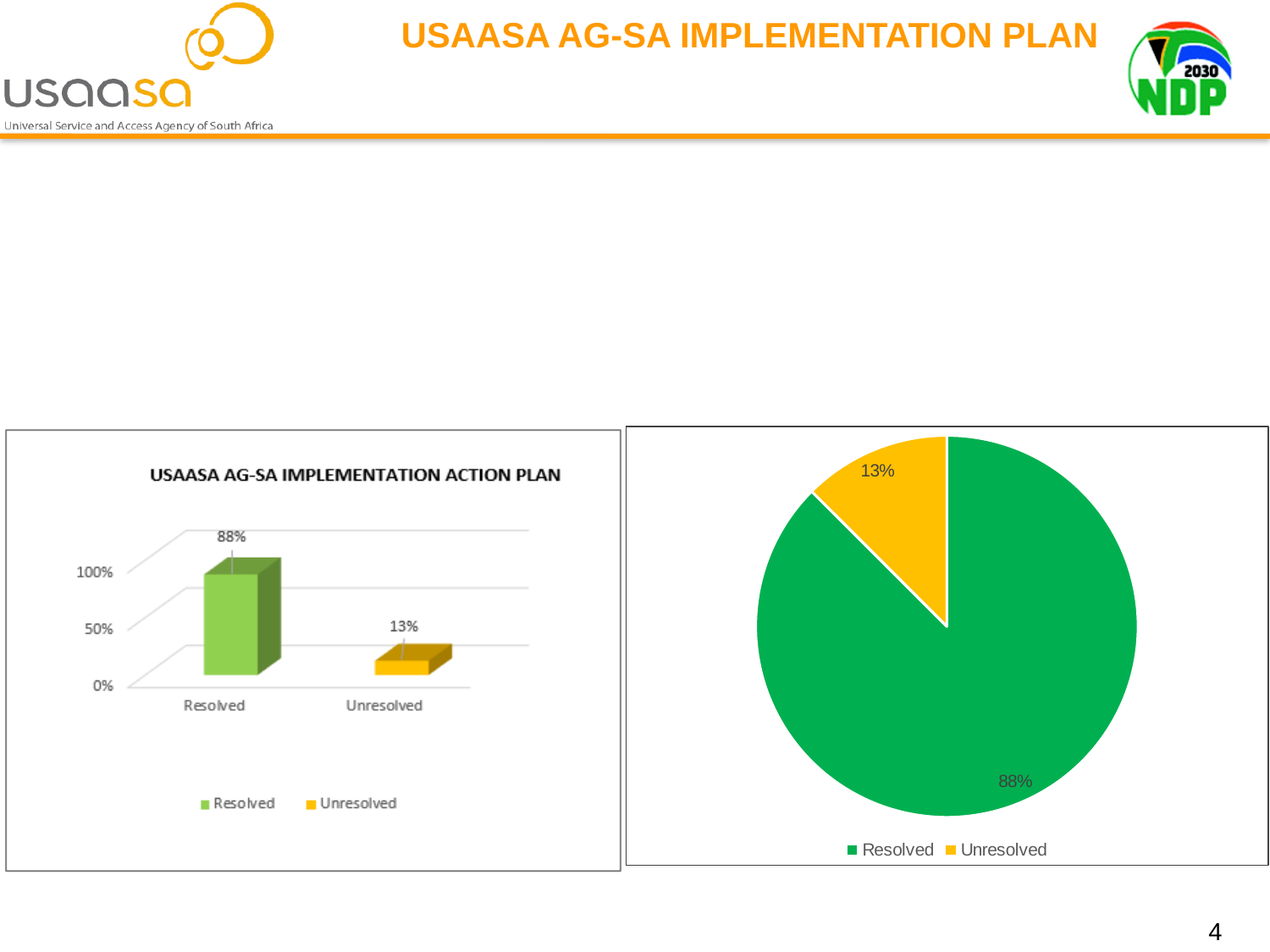
In the bar chart on the left, which category has the lowest value? Unresolved In the bar chart titled 'USAASA AG-SA IMPLEMENTATION ACTION PLAN', what is the value for Unresolved? 13% How many entries does the legend of the pie chart on the right list? 2 In the pie chart on the right, what share does the Resolved slice have? 88% In the bar chart titled 'USAASA AG-SA IMPLEMENTATION ACTION PLAN', what is the value for Resolved? 88% In the bar chart on the left, which category has the highest value? Resolved In the bar chart on the left, how many categories are shown on the x axis? 2 What kind of chart is the chart on the right of the slide? Pie chart In the pie chart on the right, what share does the Unresolved slice have? 13% What kind of chart is the chart on the left of the slide? Bar chart In the bar chart on the left, what is the difference between the Resolved and Unresolved values? 75% In the pie chart on the right, which slice is larger, Resolved or Unresolved? Resolved